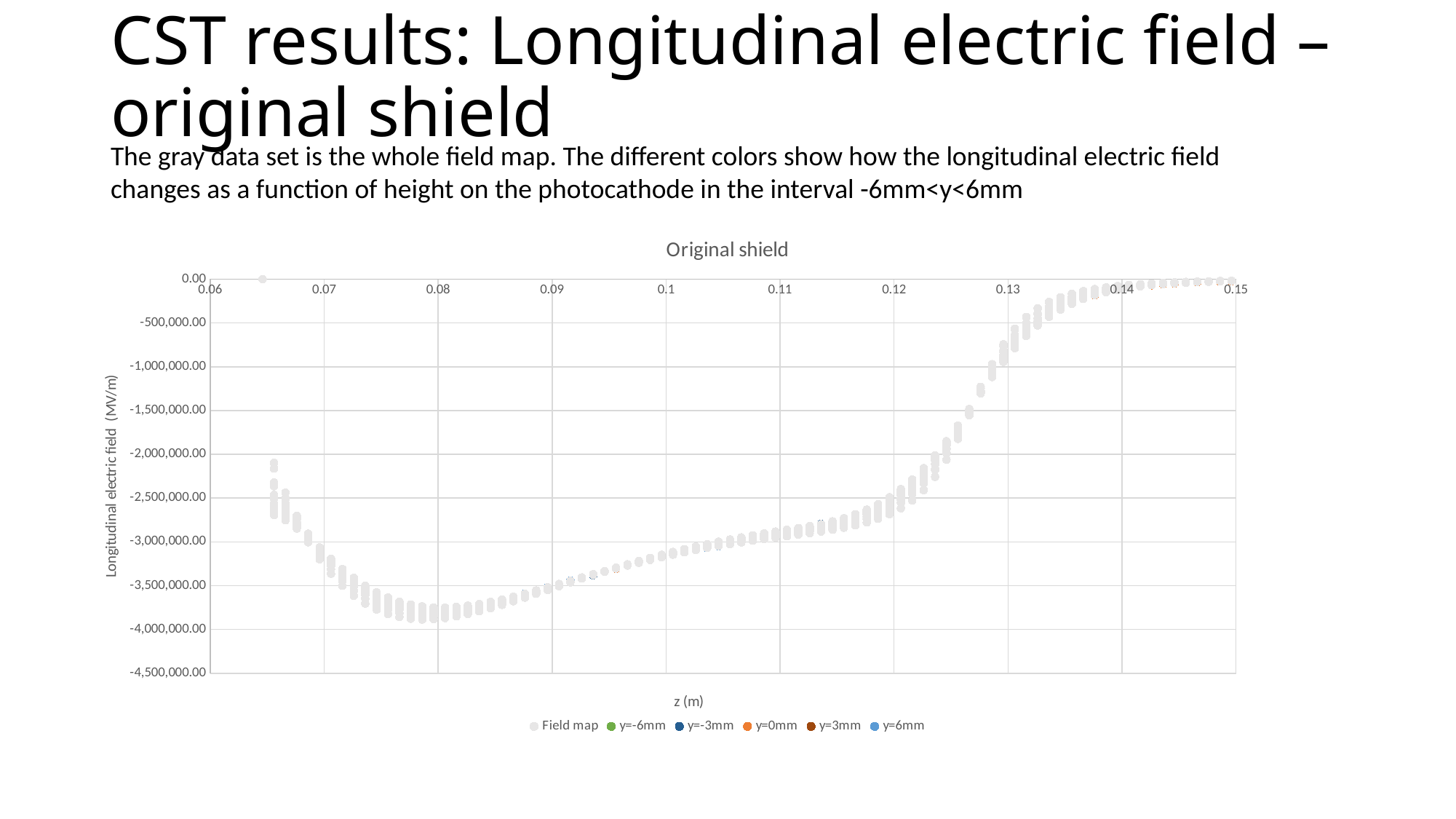
Is the value of the field map at z=0.08 greater or less than -3,500,000.00? less How many series does the legend of the chart list? 6 Is the value of the field map at z=0.14 greater or less than -500,000.00? greater Do the field map values rise or fall along the x axis between z=0.08 and z=0.15? rise Is the value of the field map at z=0.13 greater or less than -2,000,000.00? greater What is the label of the x axis of the chart? z (m) Which is higher, the field map value at z=0.09 or at z=0.14? z=0.14 What is the title of the chart? Original shield How many tick labels are shown on the x axis of the chart? 10 What kind of chart is shown on the slide? scatter chart